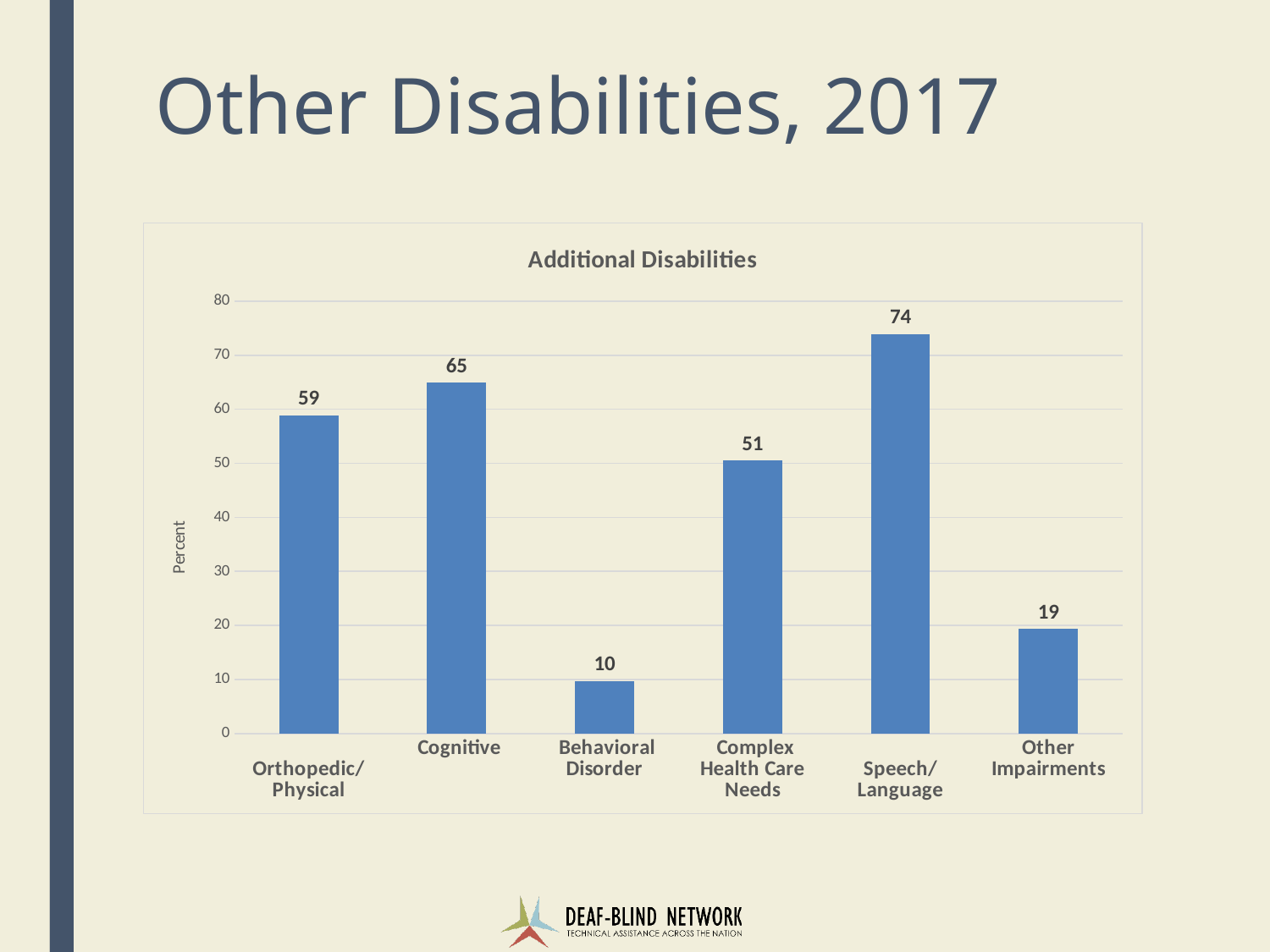
How many categories are shown in the chart? 6 What is the difference between the values for Speech/Language and Orthopedic/Physical? 15 What is the value for Behavioral Disorder? 10 Which is larger, the value for Cognitive or the value for Complex Health Care Needs? Cognitive What kind of chart is shown on the slide? bar chart Which category has the lowest value? Behavioral Disorder What is the title of the chart? Additional Disabilities What is the value for Complex Health Care Needs? 51 Which category has the highest value? Speech/Language What is the value for Speech/Language? 74 What is the value for Cognitive? 65 Is the value for Other Impairments greater or less than 30? less